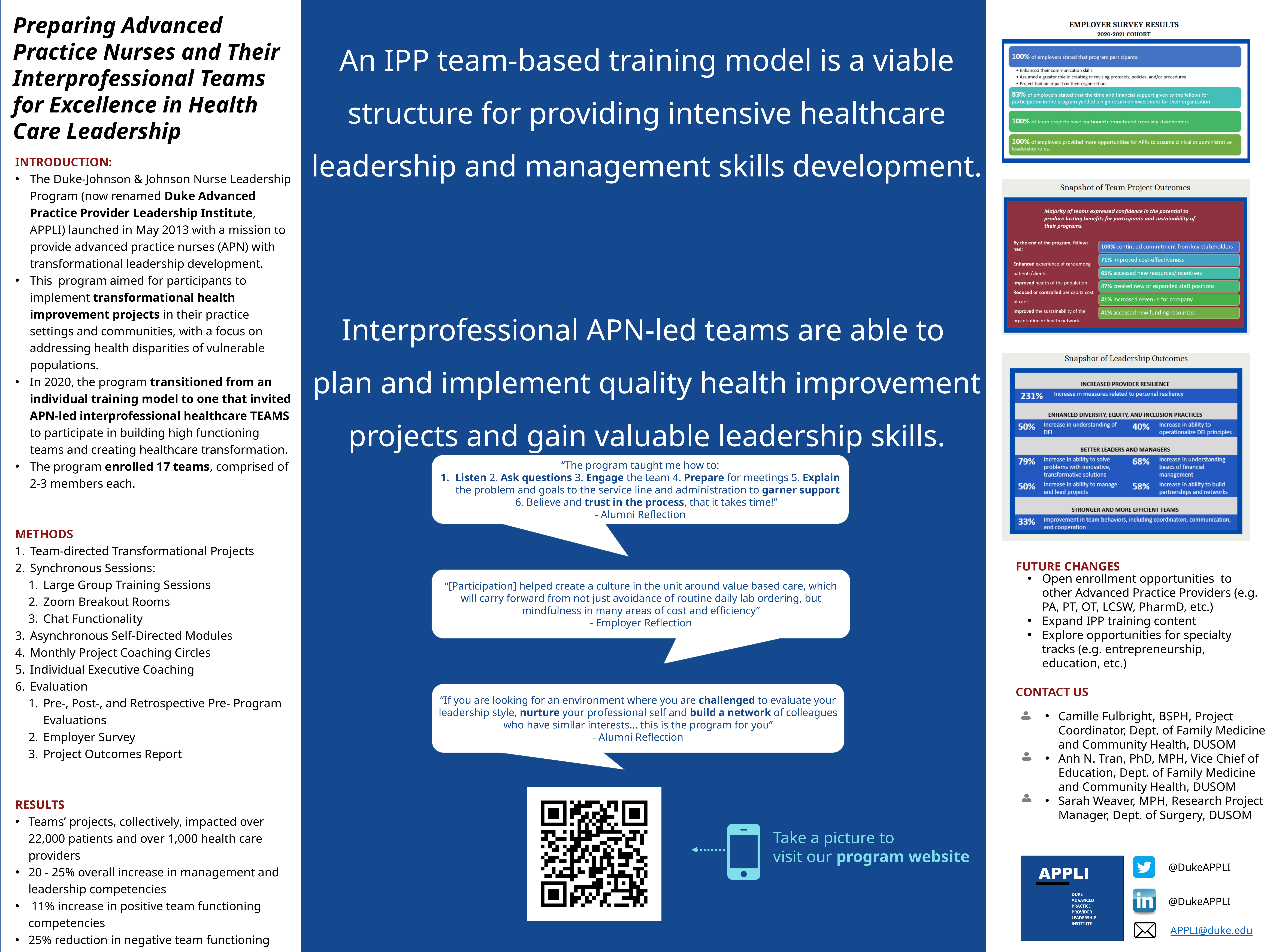
In the Snapshot of Leadership Outcomes panel, what is the increase in ability to solve problems with innovative, transformative solutions? 79% In the Snapshot of Team Project Outcomes panel, which is larger: the percentage that accessed new resources/incentives or the percentage that increased revenue for company? accessed new resources/incentives In the Snapshot of Leadership Outcomes panel, what is the reported increase in measures related to personal resiliency? 231% In the Snapshot of Team Project Outcomes panel, which outcome has the highest percentage? continued commitment from key stakeholders What is the title of the panel that lists outcomes such as improved cost-effectiveness and increased revenue for company? Snapshot of Team Project Outcomes In the Snapshot of Team Project Outcomes panel, what percentage improved cost-effectiveness? 71% In the Snapshot of Team Project Outcomes panel, what is the difference between the percentage that improved cost-effectiveness and the percentage that created new or expanded staff positions? 24% In the Snapshot of Team Project Outcomes panel, what percentage accessed new resources/incentives? 65% How many outcome bars are shown in the Snapshot of Team Project Outcomes panel? 6 In the Snapshot of Team Project Outcomes panel, what percentage of teams continued commitment from key stakeholders? 100% In the Snapshot of Team Project Outcomes panel, what percentage created new or expanded staff positions? 47% In the Employer Survey Results panel, what percentage of employers stated that the time and financial support given to the fellows yielded a high return on investment? 83%